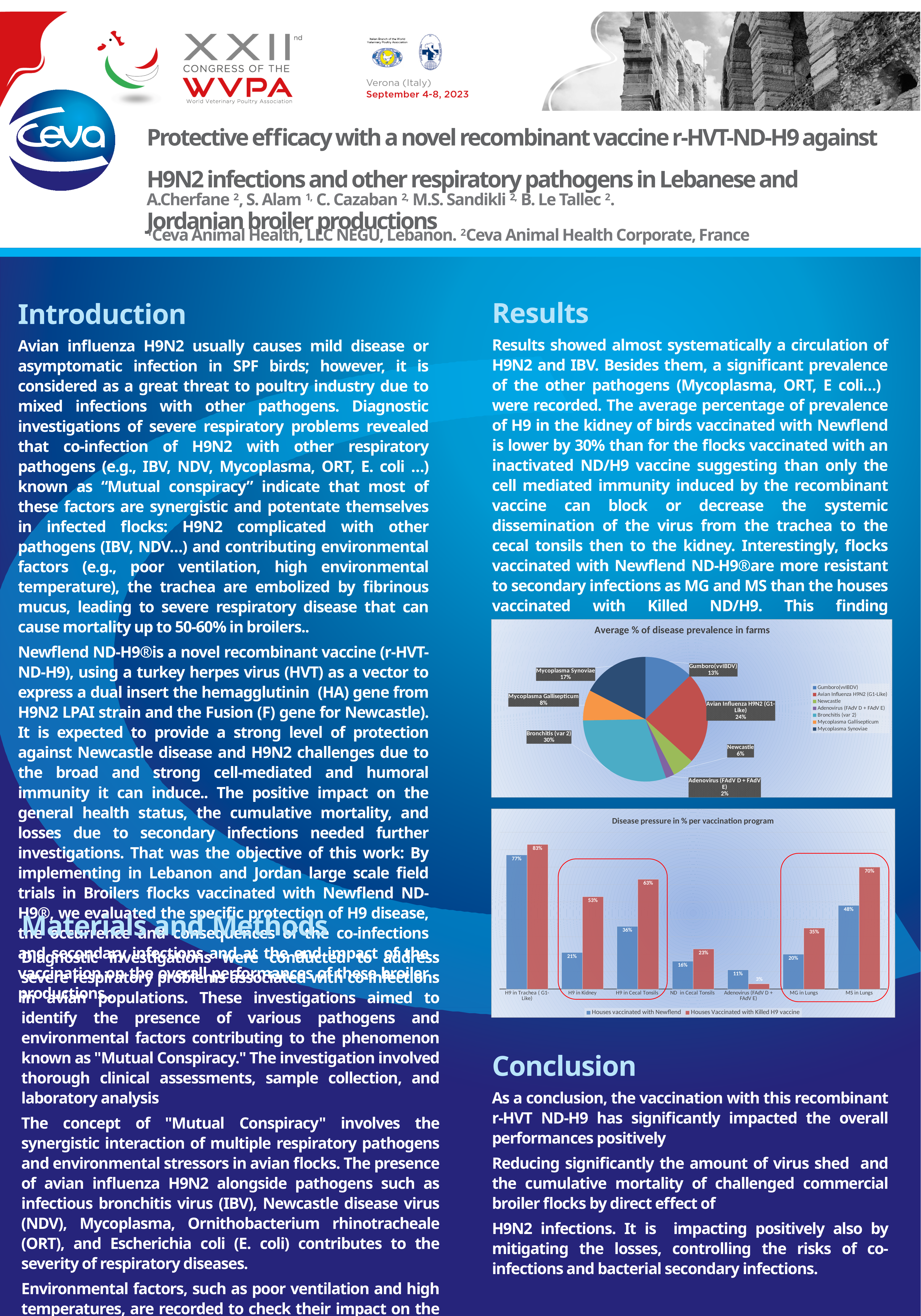
In the bar chart 'Disease pressure in % per vaccination program', what is the value for H9 in Kidney in houses vaccinated with Newflend? 21% What type of chart is 'Disease pressure in % per vaccination program'? Bar chart In the pie chart 'Average % of disease prevalence in farms', which disease has the smallest slice? Adenovirus (FAdV D + FAdV E) In the pie chart 'Average % of disease prevalence in farms', how many diseases are shown? 7 In the pie chart 'Average % of disease prevalence in farms', what share does Bronchitis (var 2) have? 30% In the bar chart 'Disease pressure in % per vaccination program', which vaccination program has the higher value for Adenovirus (FAdV D + FAdV E)? Houses vaccinated with Newflend In the bar chart 'Disease pressure in % per vaccination program', what is the difference between the Killed H9 vaccine and Newflend values for H9 in Cecal Tonsils? 27% In the bar chart 'Disease pressure in % per vaccination program', how many series does the legend list? 2 In the bar chart 'Disease pressure in % per vaccination program', what is the value for MS in Lungs in houses vaccinated with Killed H9 vaccine? 70% In the pie chart 'Average % of disease prevalence in farms', what is the percentage for Mycoplasma Synoviae? 17% In the pie chart 'Average % of disease prevalence in farms', which disease has the largest slice? Bronchitis (var 2) In the bar chart 'Disease pressure in % per vaccination program', which category has the highest value for houses vaccinated with Killed H9 vaccine? H9 in Trachea (G1-Like)